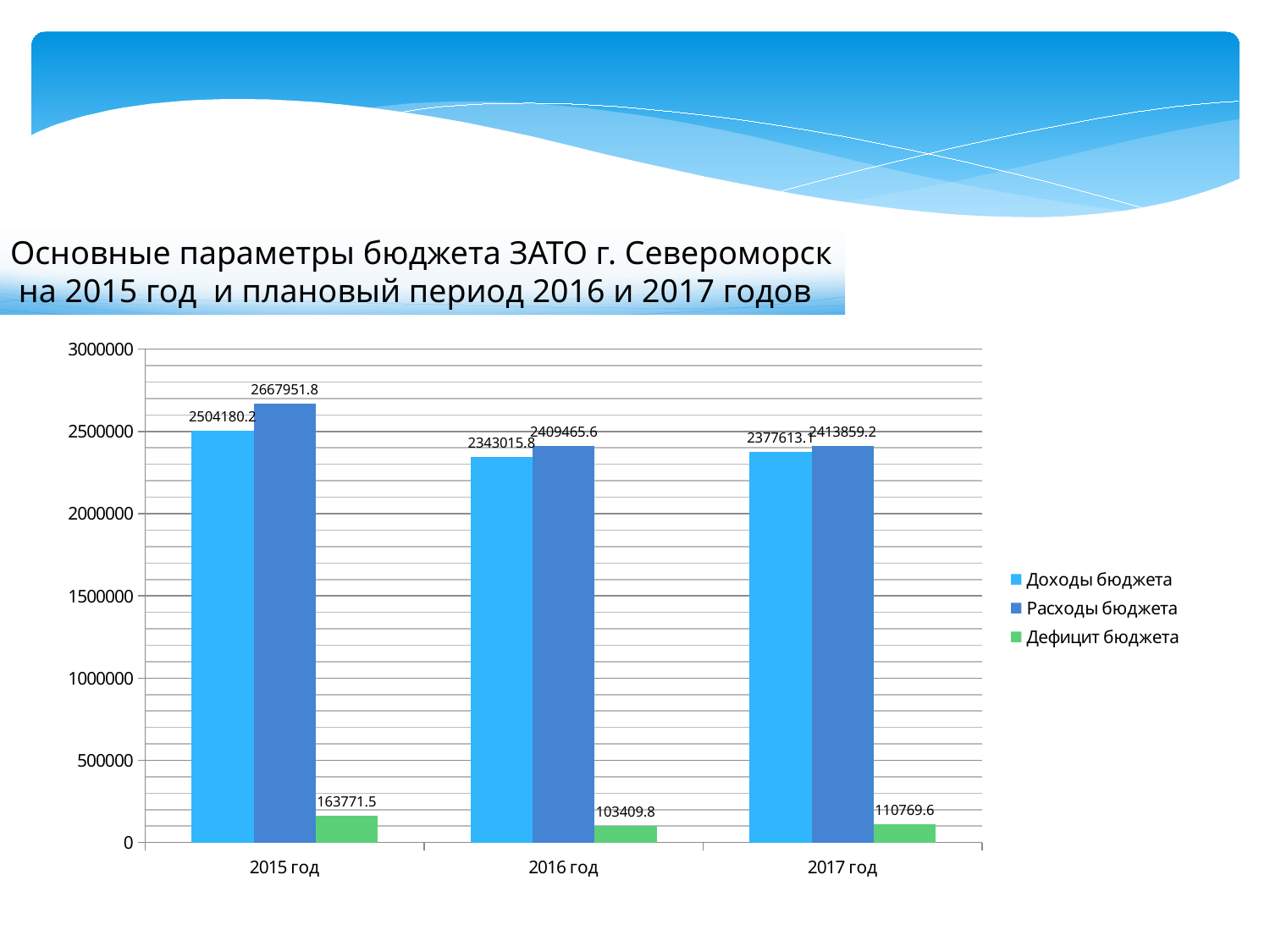
In which year is Расходы бюджета the highest? 2015 год In which year is Дефицит бюджета the lowest? 2016 год What is the value of Расходы бюджета for 2016 год? 2409465.6 Which is larger: Доходы бюджета in 2016 год or in 2017 год? 2017 год Is the value of Расходы бюджета for 2015 год greater or less than 2500000? greater What is the value of Дефицит бюджета for 2017 год? 110769.6 Which series is shown in green in the legend? Дефицит бюджета How many year categories are shown on the x axis? 3 What is the value of Доходы бюджета for 2015 год? 2504180.2 What is the difference between Дефицит бюджета in 2015 год and 2016 год? 60361.7 How many series does the legend list? 3 What type of chart is shown on the slide? bar chart